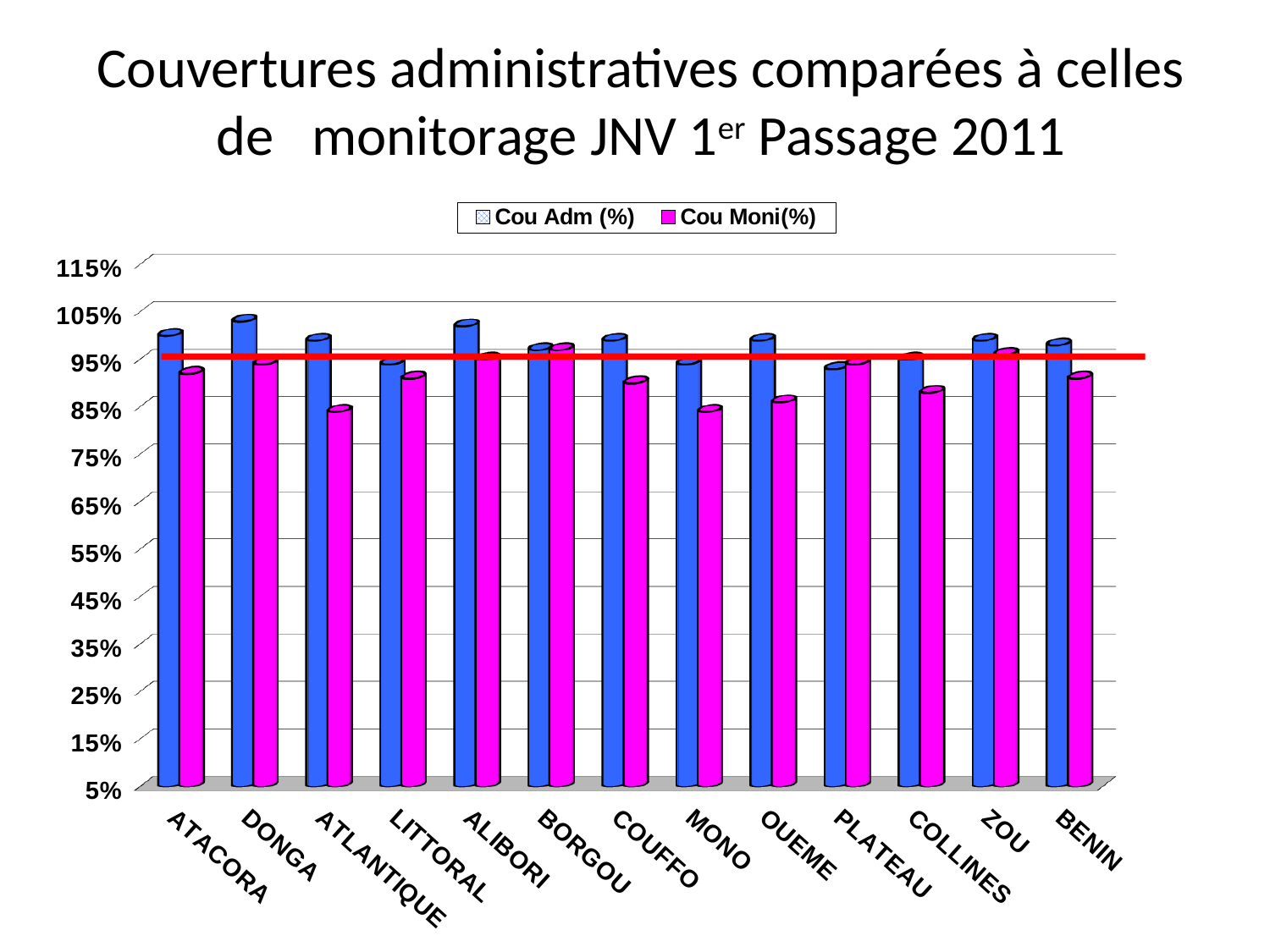
What kind of chart is shown on the slide? bar chart Is the Cou Moni(%) value for ATLANTIQUE greater or less than 95%? less Is the Cou Adm (%) value for ALIBORI greater or less than 95%? greater Is the Cou Moni(%) value for COUFFO greater or less than 95%? less How many series does the legend list? 2 What are the two series named in the legend? Cou Adm (%) and Cou Moni(%) How many categories are shown on the x axis? 13 Which colour represents the Cou Moni(%) series? magenta For DONGA, which is larger: Cou Adm (%) or Cou Moni(%)? Cou Adm (%) For ATLANTIQUE, which is larger: Cou Adm (%) or Cou Moni(%)? Cou Adm (%)